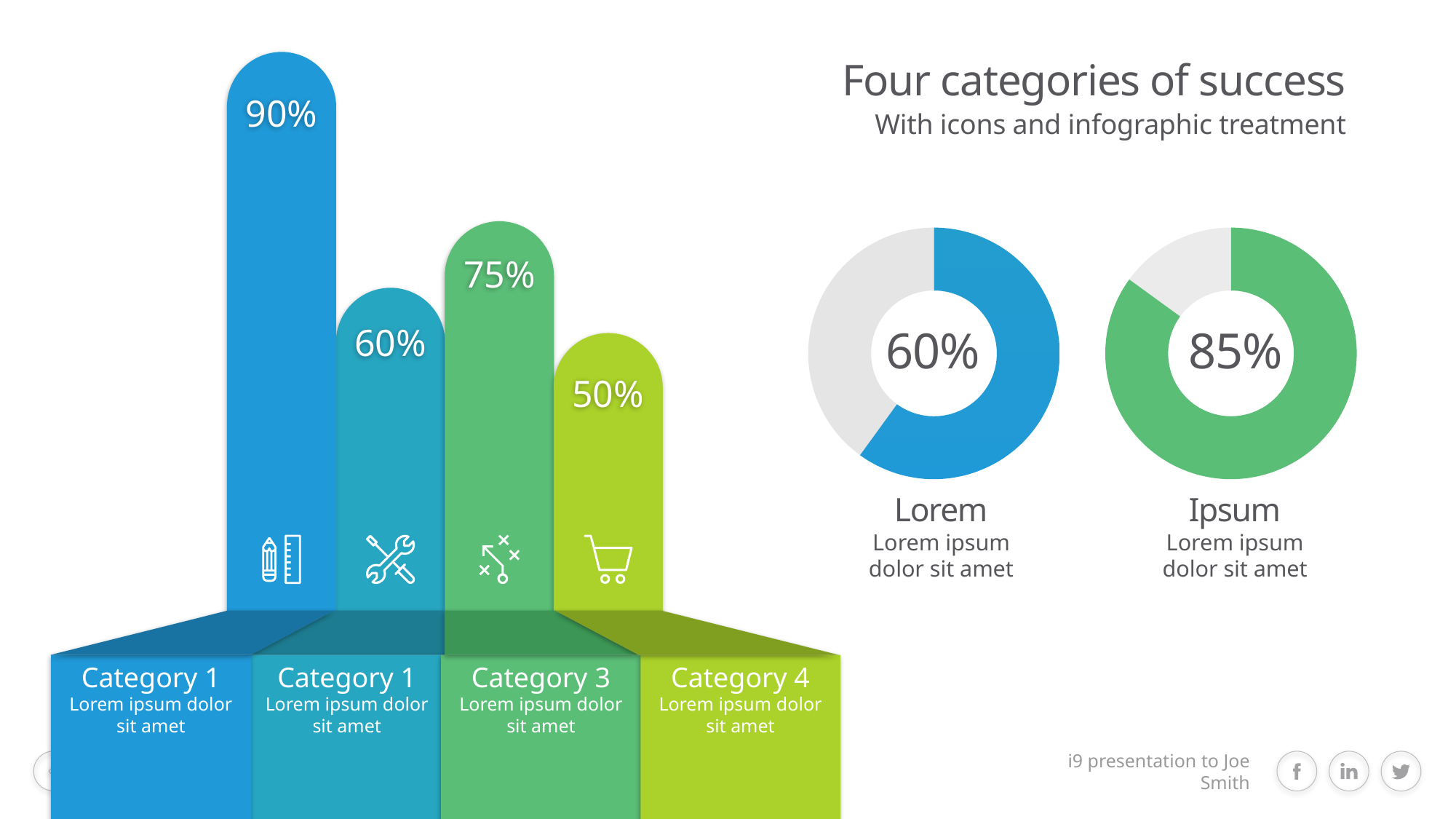
On the bar chart on the left, what value is shown on the second bar from the left (teal)? 60% On the bar chart on the left, what value is shown on the bar labelled Category 3? 75% On the donut chart labelled Ipsum, what percentage is shown in the centre? 85% On the bar chart on the left, what is the difference between the value of Category 3 and the value of Category 4? 25% On the bar chart on the left, which bar has the highest value? The leftmost bar (90%) On the donut chart labelled Lorem, what percentage is shown in the centre? 60% What kind of chart is shown on the left side of the slide? Bar chart On the bar chart on the left, which category has the lowest value? Category 4 On the bar chart on the left, which is larger: the value for Category 3 or the value for Category 4? Category 3 How many bars are shown on the bar chart on the left? 4 On the bar chart on the left, what value is shown on the leftmost (dark blue) bar? 90% On the bar chart on the left, what value is shown on the bar labelled Category 4? 50%